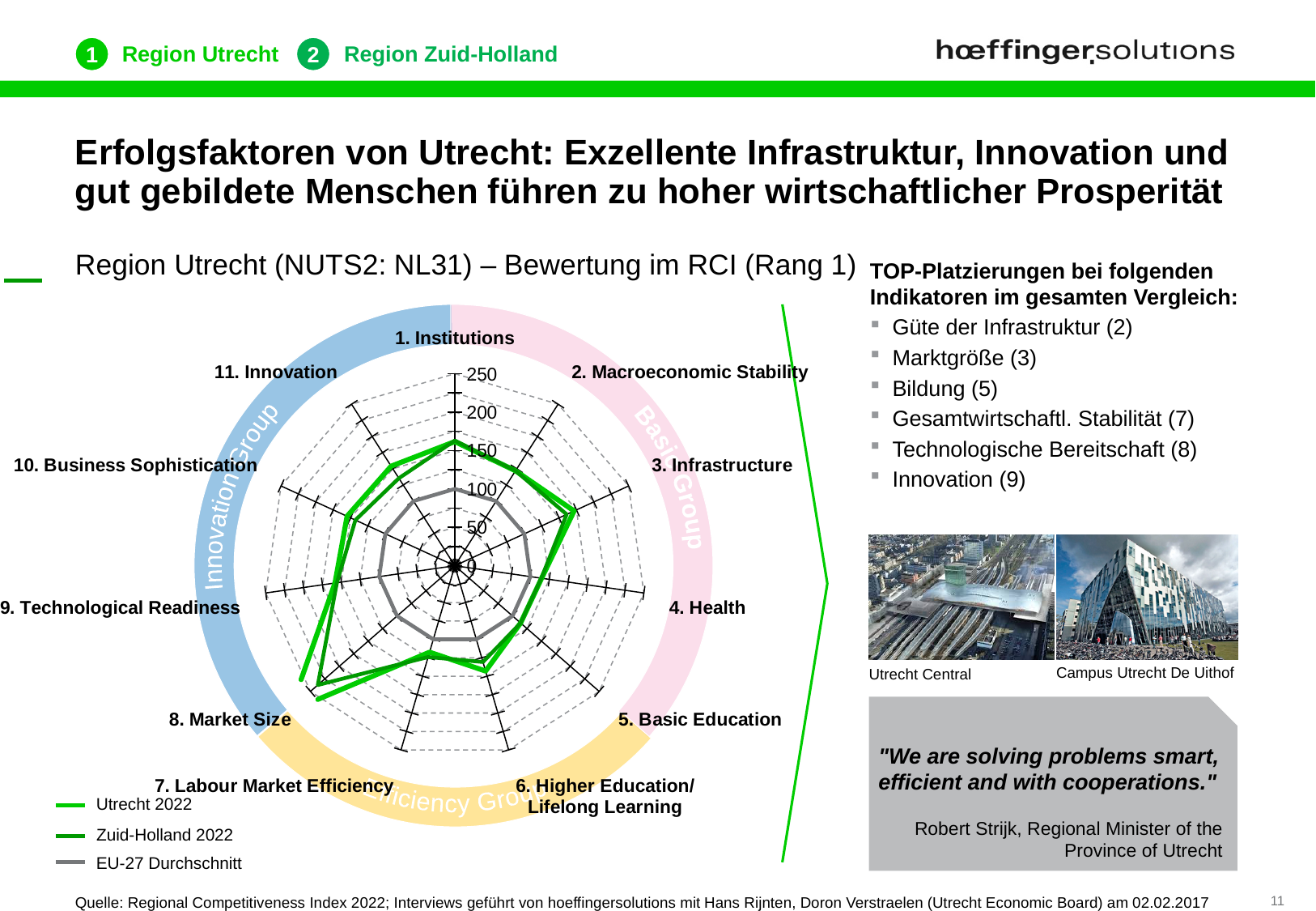
How many categories (axes) does the radar chart have? 11 Which is larger for 3. Infrastructure: the Utrecht 2022 value or the EU-27 Durchschnitt value? Utrecht 2022 How many series does the legend of the radar chart list? 3 Is the Utrecht 2022 value for 3. Infrastructure greater or less than 150? greater For Utrecht 2022, which is larger: the value for 8. Market Size or the value for 4. Health? 8. Market Size What kind of chart is shown on the slide? Radar chart Is the Utrecht 2022 value for 4. Health greater or less than 150? less Is the EU-27 Durchschnitt value for 3. Infrastructure greater or less than 150? less What are the three series listed in the legend of the radar chart? Utrecht 2022, Zuid-Holland 2022, EU-27 Durchschnitt What is the title of the radar chart? Region Utrecht (NUTS2: NL31) – Bewertung im RCI (Rang 1) What is the maximum value shown on the radar chart's axis scale? 250